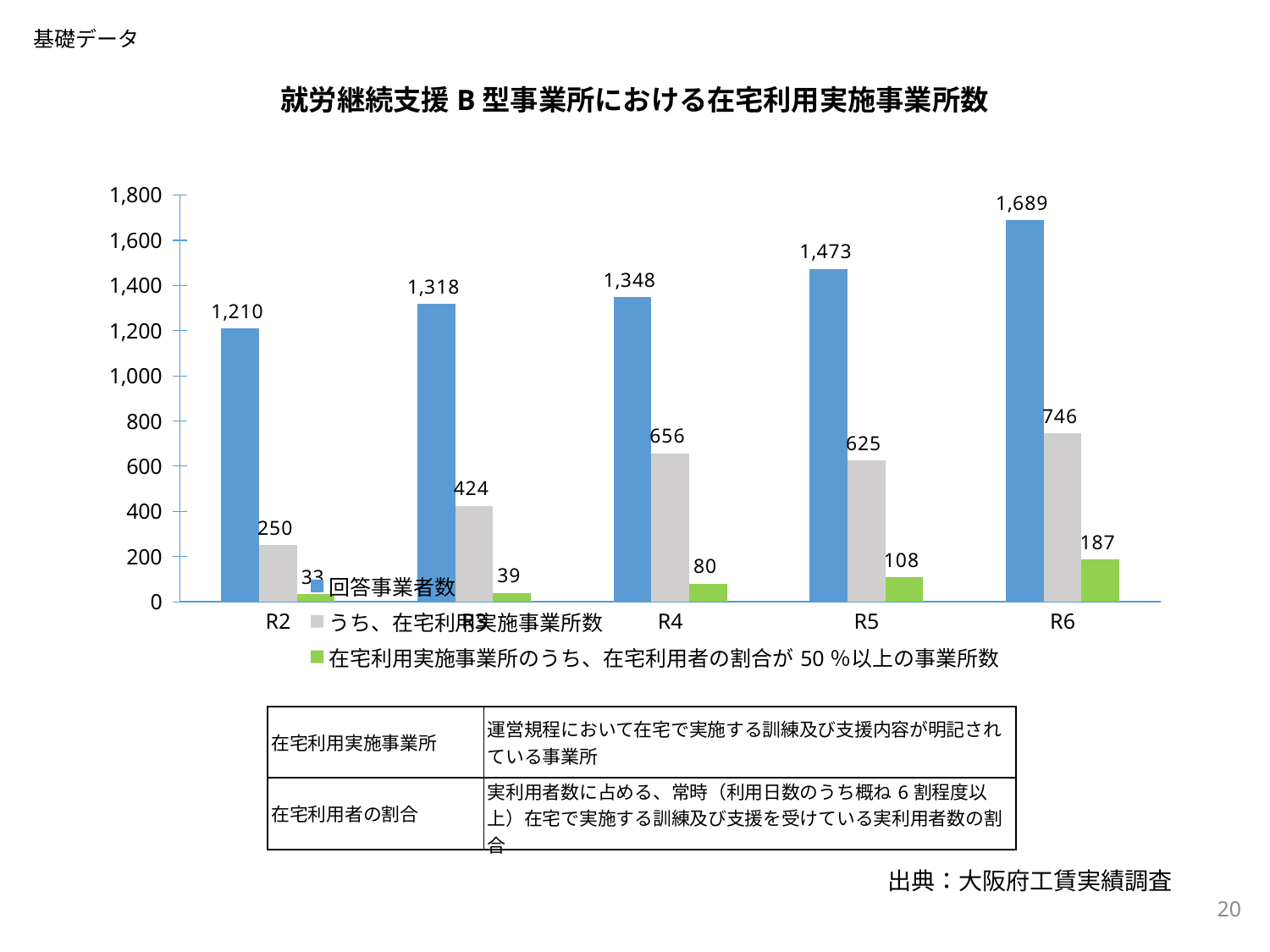
このグラフの種類は何ですか？ 棒グラフ R2の回答事業者数は1,000より多いですか、少ないですか？ 多い R5の「在宅利用実施事業所のうち、在宅利用者の割合が50%以上の事業所数」はいくつですか？ 108 R6の回答事業者数はいくつですか？ 1,689 凡例にはいくつの系列が示されていますか？ 3 回答事業者数が最も多い年度はどれですか？ R6 「うち、在宅利用実施事業所数」が最も少ない年度はどれですか？ R2 回答事業者数はR2からR6にかけて増加していますか、減少していますか？ 増加 R6とR2の回答事業者数の差はいくつですか？ 479 R4の「うち、在宅利用実施事業所数」はいくつですか？ 656 「うち、在宅利用実施事業所数」はR4とR5のどちらが多いですか？ R4 横軸にはいくつの年度が示されていますか？ 5